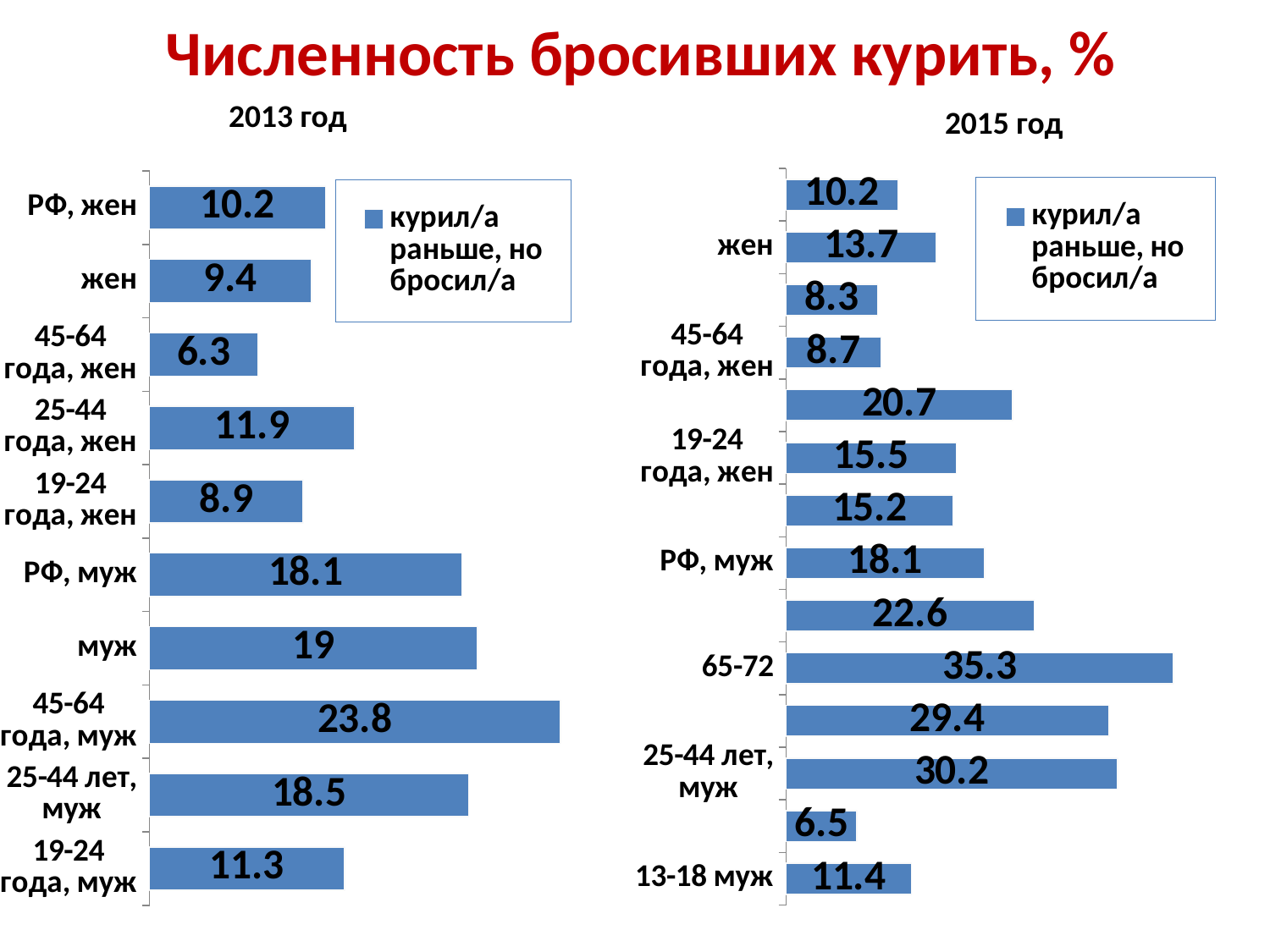
In the 2013 год chart, what is the value for 45-64 года, муж? 23.8 How many series does the legend of the 2013 год chart list? 1 In the 2013 год chart, which category has the highest value? 45-64 года, муж In the 2013 год chart, what is the difference between the values for муж and жен? 9.6 In the 2015 год chart, which category has the highest value? 65-72 In the 2015 год chart, what is the value for 65-72? 35.3 In the 2013 год chart, which is larger: the value for РФ, жен or the value for 25-44 года, жен? 25-44 года, жен In the 2013 год chart, what is the value for 19-24 года, жен? 8.9 In the 2013 год chart, which category has the lowest value? 45-64 года, жен How many categories are shown in the 2013 год chart? 10 In the 2015 год chart, what is the value for 25-44 лет, муж? 30.2 What type of chart is the 2015 год chart? bar chart